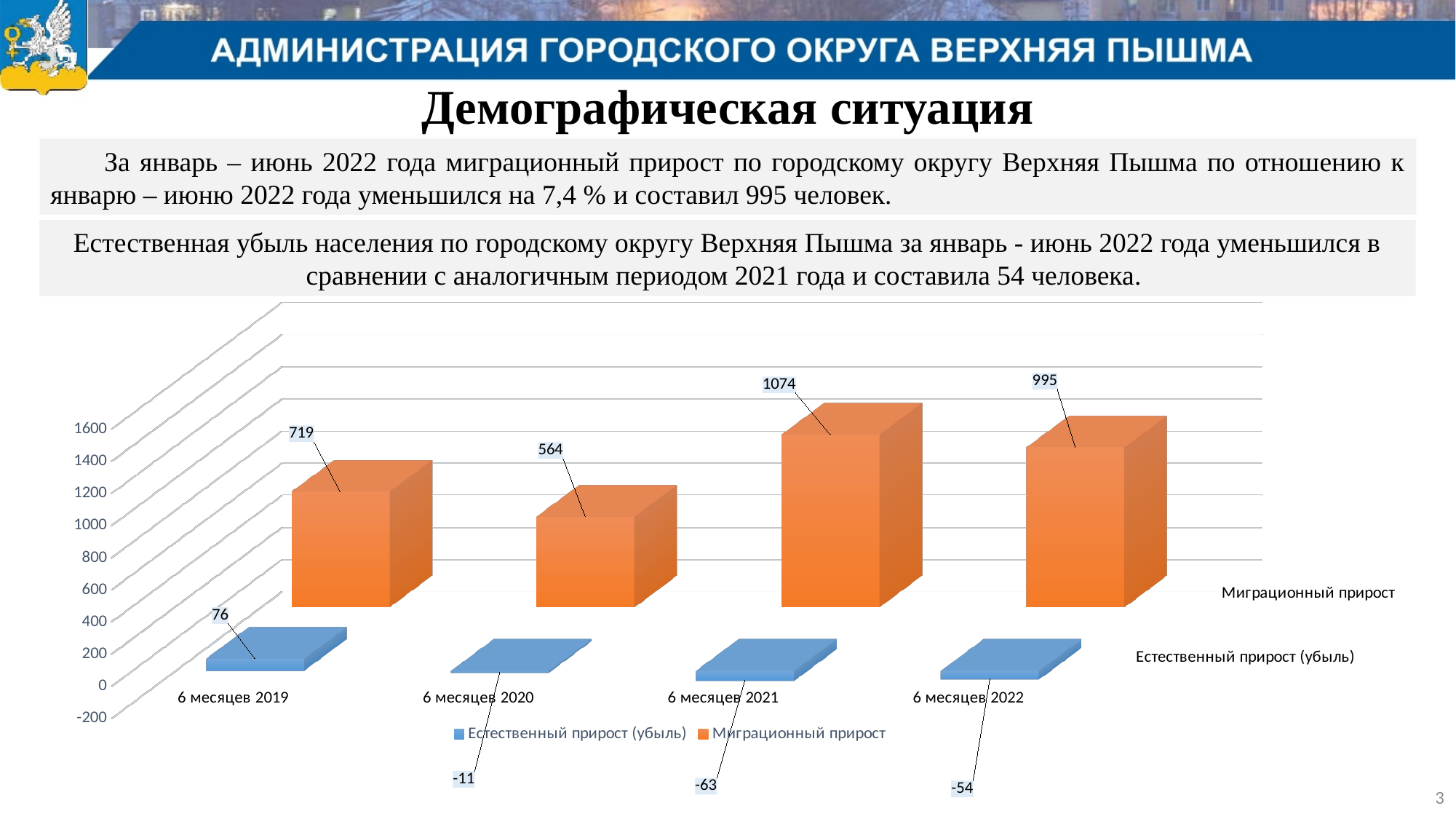
What is the difference between Миграционный прирост for 6 месяцев 2021 and 6 месяцев 2022? 79 In which period is Миграционный прирост the highest? 6 месяцев 2021 What is the value of Миграционный прирост for 6 месяцев 2021? 1074 Which is larger: Миграционный прирост for 6 месяцев 2019 or for 6 месяцев 2022? 6 месяцев 2022 In which period is Естественный прирост (убыль) the lowest? 6 месяцев 2021 In which period is Миграционный прирост the lowest? 6 месяцев 2020 What is the value of Миграционный прирост for 6 месяцев 2020? 564 How many series does the chart legend list? 2 How many periods (categories) are shown on the x axis of the chart? 4 What type of chart is shown on the slide? Bar chart What is the value of Естественный прирост (убыль) for 6 месяцев 2019? 76 What is the value of Естественный прирост (убыль) for 6 месяцев 2022? -54